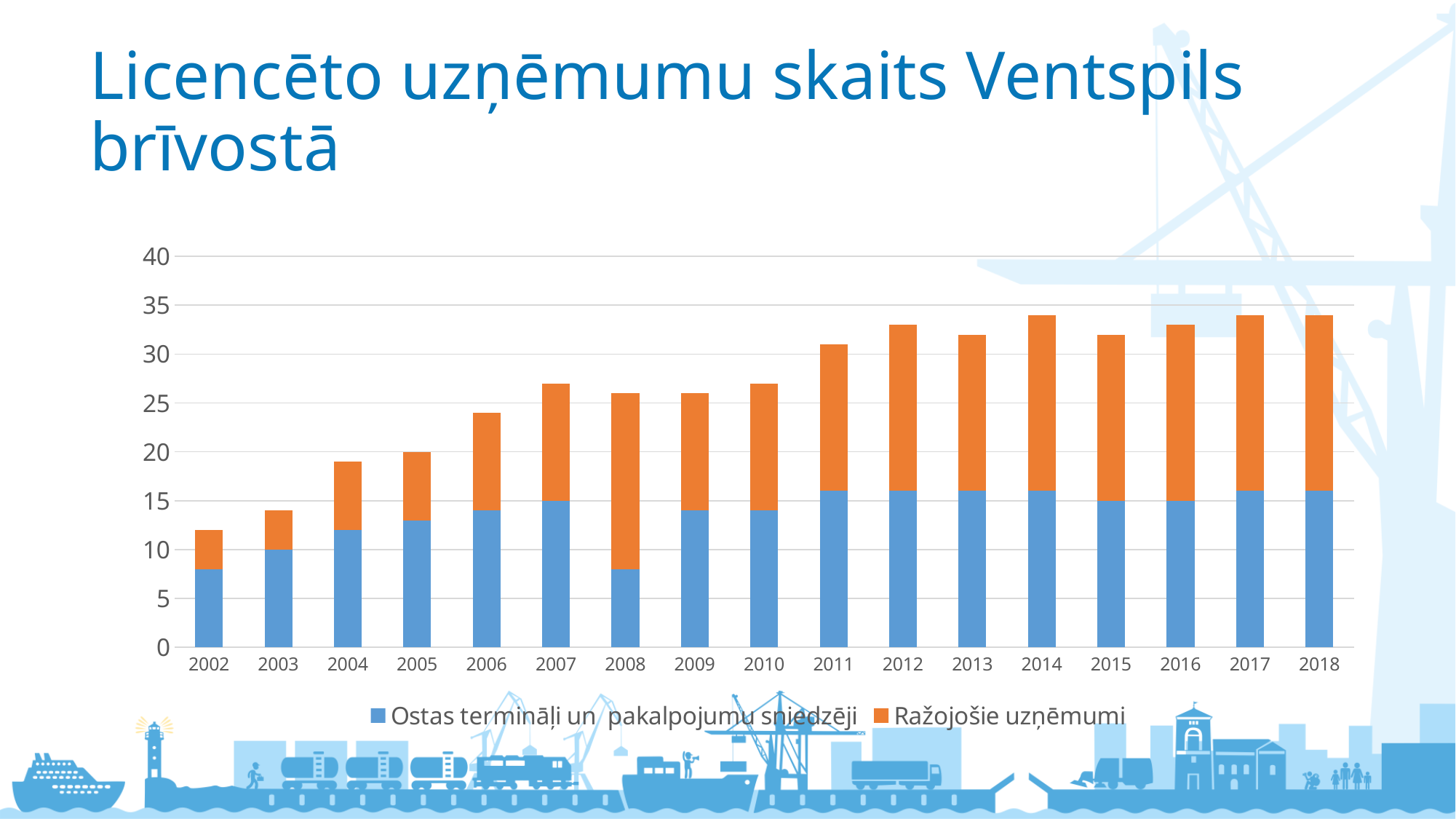
Is the total value for 2002 greater or less than 15? less What colour represents Ražojošie uzņēmumi in the chart? orange Which year has the larger total, 2003 or 2010? 2010 Is the total value for 2018 greater or less than 30? greater What kind of chart is shown on the slide? stacked bar chart Which year has the larger value for Ostas termināļi un pakalpojumu sniedzēji, 2002 or 2007? 2007 How many years are shown on the x axis of the chart? 17 Is the total value for 2007 greater or less than 25? greater Which year has the lowest total number of licensed companies? 2002 Do the total values generally rise or fall from 2002 to 2018? rise How many series does the legend list? 2